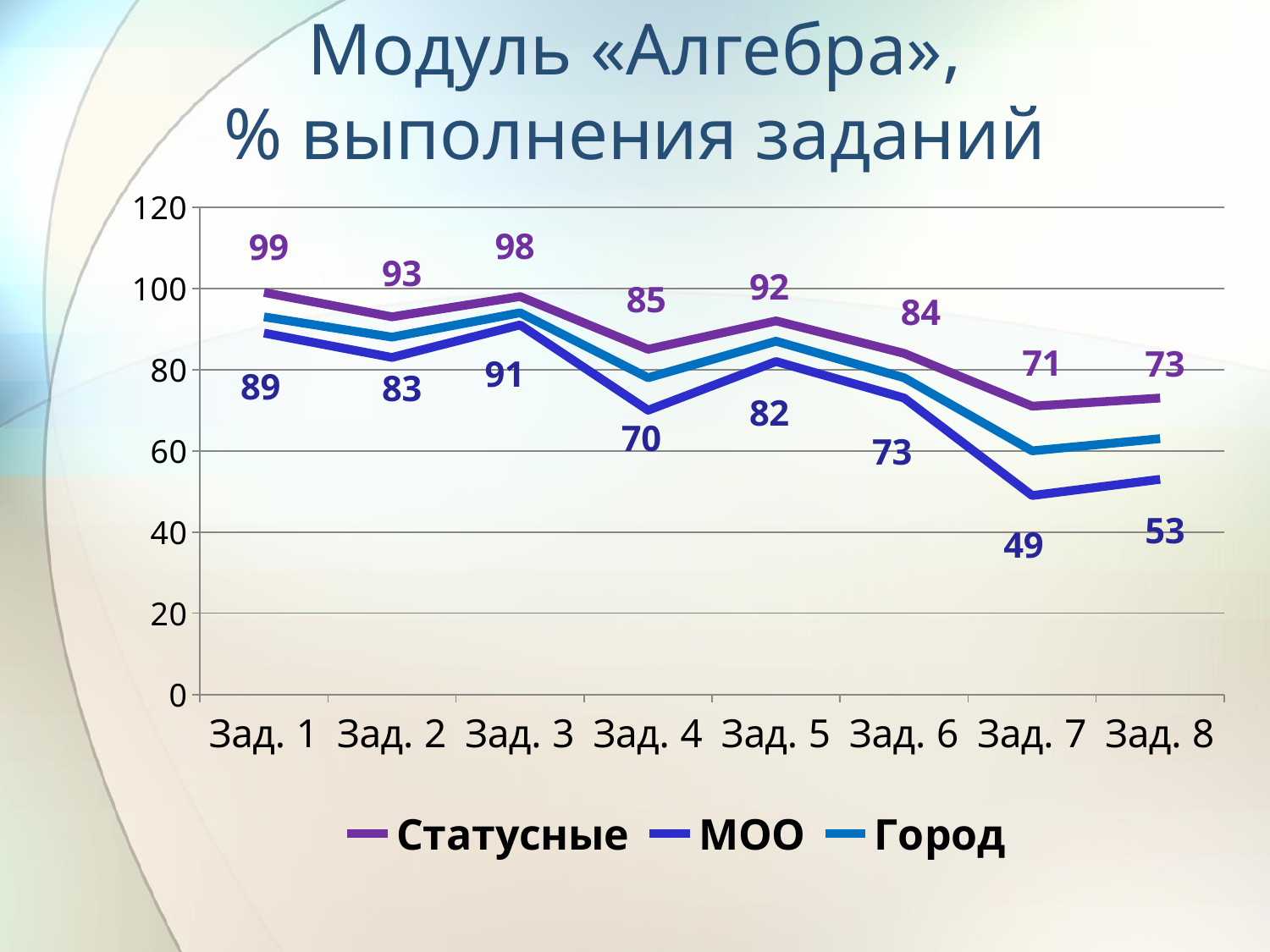
What is the value for Статусные at Зад. 1? 99 What is the value for Статусные at Зад. 6? 84 What type of chart is shown on the slide? line chart How many series does the legend list? 3 What is the value for МОО at Зад. 7? 49 How many tasks (categories) are shown on the x axis? 8 Which is larger at Зад. 4: Статусные or МОО? Статусные What is the difference between Статусные and МОО at Зад. 7? 22 At which task is the Статусные series highest? Зад. 1 Which series is drawn in purple? Статусные Is the value for Город at Зад. 7 greater or less than 80? less At which task is the МОО series lowest? Зад. 7